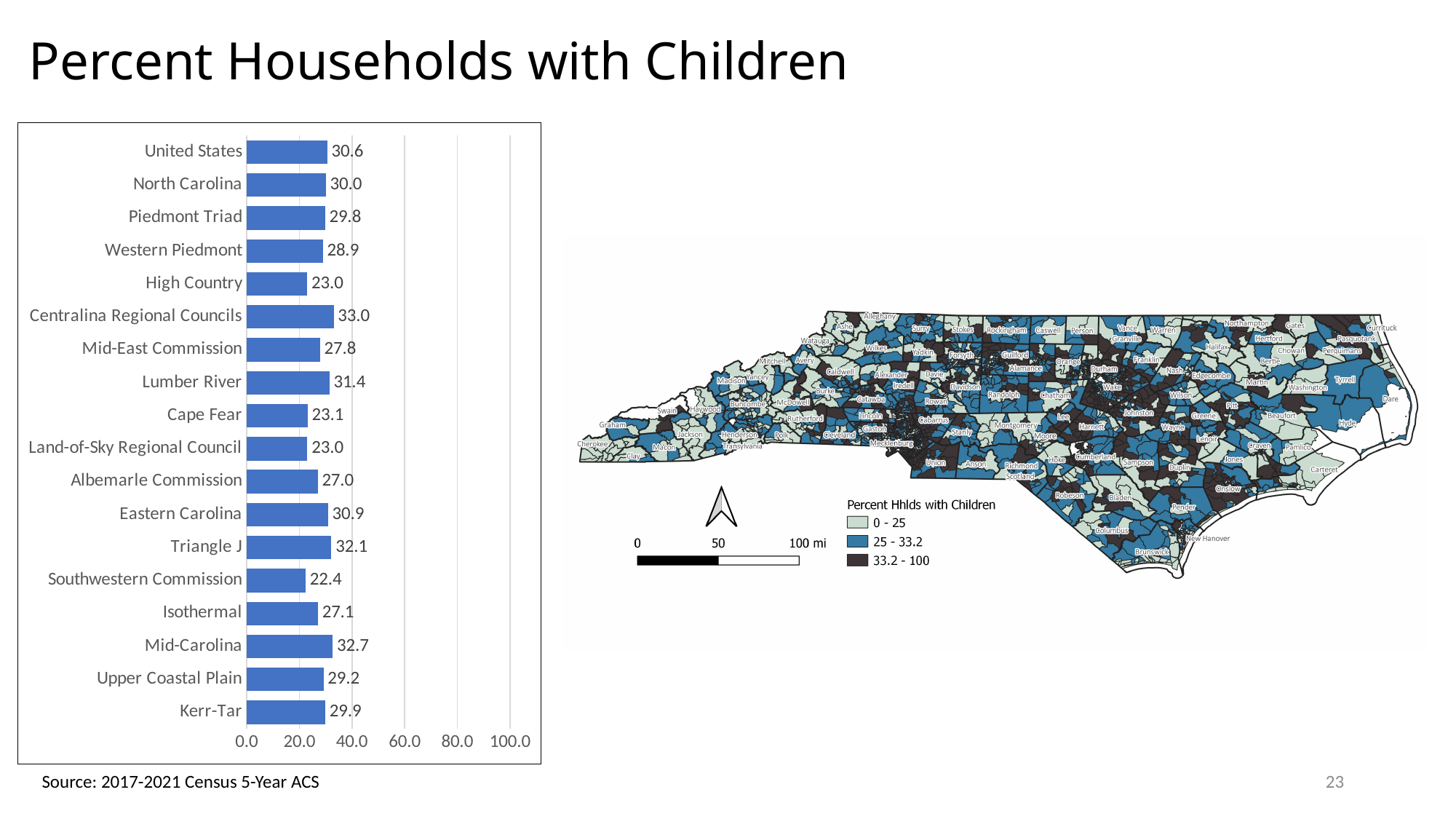
What is the value for Centralina Regional Councils in the bar chart? 33.0 What is the difference between the values for Mid-Carolina and High Country in the bar chart? 9.7 Is the value for Cape Fear in the bar chart greater or less than 40.0? less What is the difference between the values for United States and North Carolina in the bar chart? 0.6 What is the value for North Carolina in the bar chart? 30.0 What is the highest value range listed in the map legend? 33.2 - 100 Which category has the lowest value in the bar chart? Southwestern Commission Which has a larger value in the bar chart, Triangle J or Lumber River? Triangle J What kind of chart is shown on the left of the slide? bar chart What is the value for Southwestern Commission in the bar chart? 22.4 Which category has the highest value in the bar chart? Centralina Regional Councils How many categories are shown in the bar chart? 18